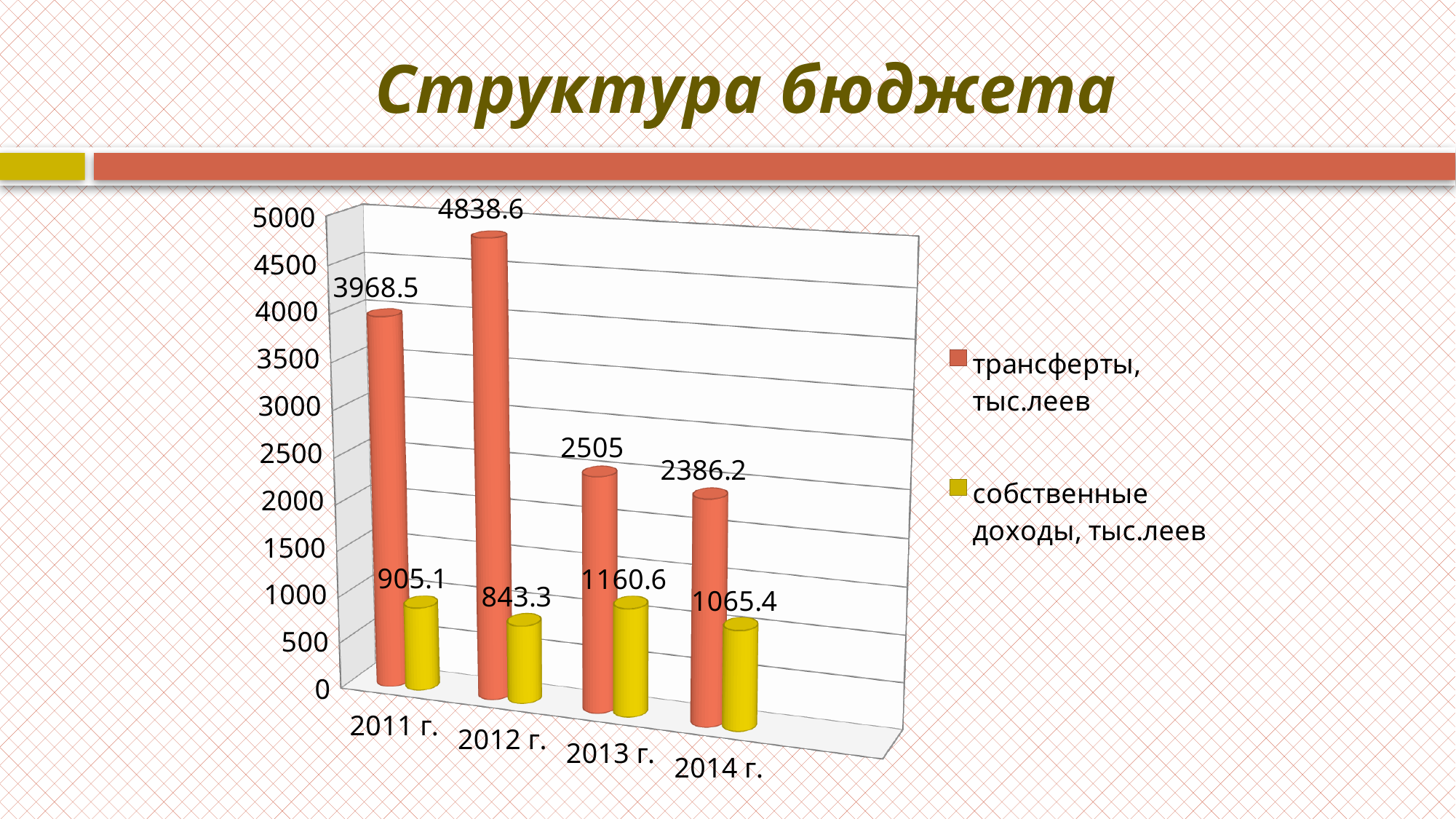
What kind of chart is shown on the slide? Bar chart In which year is собственные доходы, тыс.леев lowest? 2012 г. What is the title of the slide? Структура бюджета What is the difference between трансферты, тыс.леев in 2011 г. and 2012 г.? 870.1 How many series does the legend list? 2 In which year is трансферты, тыс.леев highest? 2012 г. What is the value of трансферты, тыс.леев for 2012 г.? 4838.6 Which is larger: собственные доходы, тыс.леев in 2013 г. or in 2014 г.? 2013 г. What is the value of собственные доходы, тыс.леев for 2011 г.? 905.1 What is the value of трансферты, тыс.леев for 2014 г.? 2386.2 What is the value of собственные доходы, тыс.леев for 2013 г.? 1160.6 How many years are shown on the x axis? 4